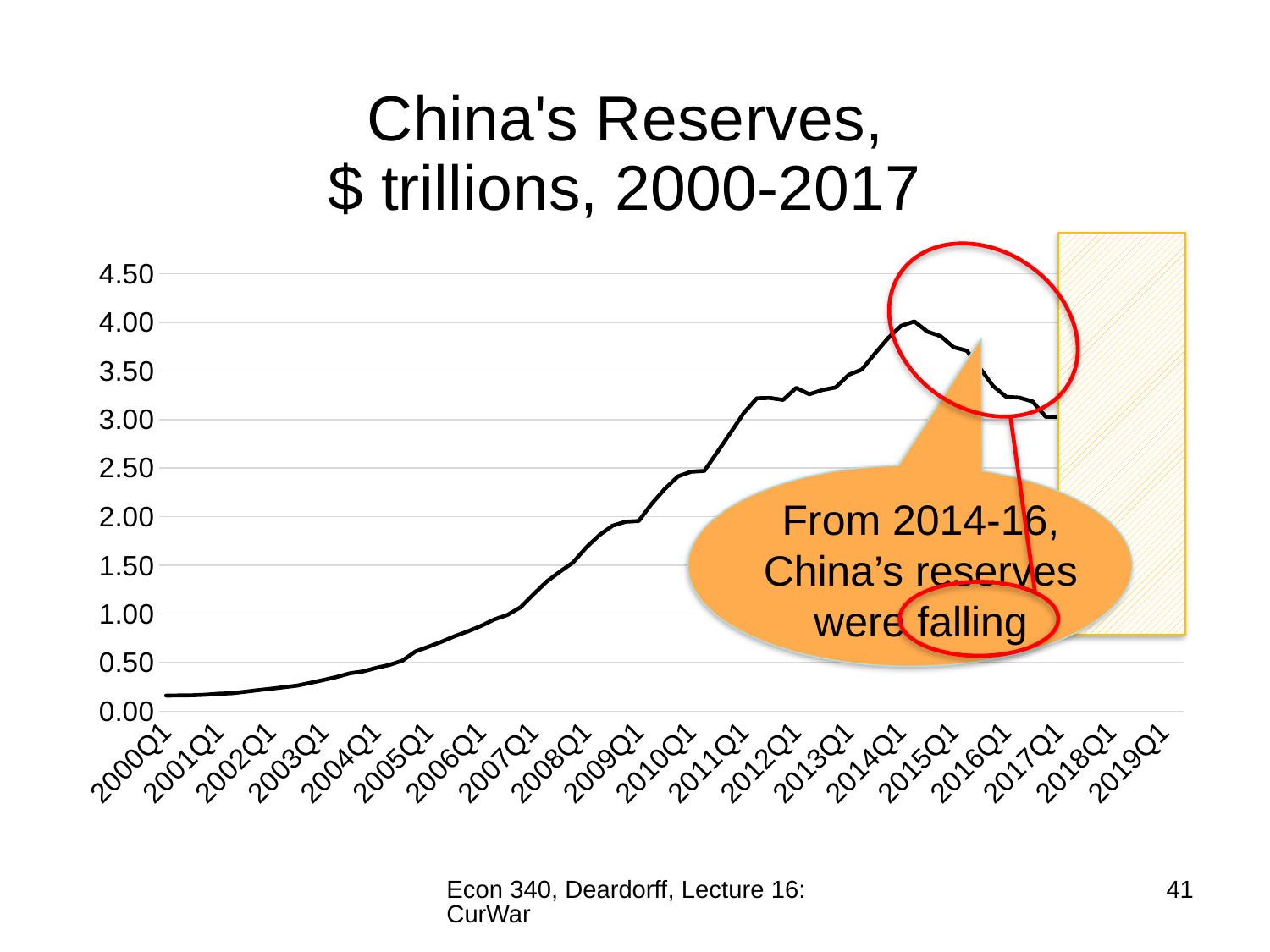
Is the value for 2014Q1 greater or less than 3.50? greater According to the callout on the chart, what happened to China's reserves from 2014-16? they were falling Which x-axis label marks the lowest point of the line? 2000Q1 Which is larger, the value for 2012Q1 or the value for 2008Q1? 2012Q1 Do the values rise or fall from 2000Q1 to 2014Q1? rise What kind of chart is shown on the slide? line chart How many quarter labels are shown along the x axis? 20 Is the value for 2008Q1 greater or less than 1.00? greater Is the value for 2000Q1 greater or less than 0.50? less What is the title of the chart? China's Reserves, $ trillions, 2000-2017 In which year does the line reach its highest point? 2014